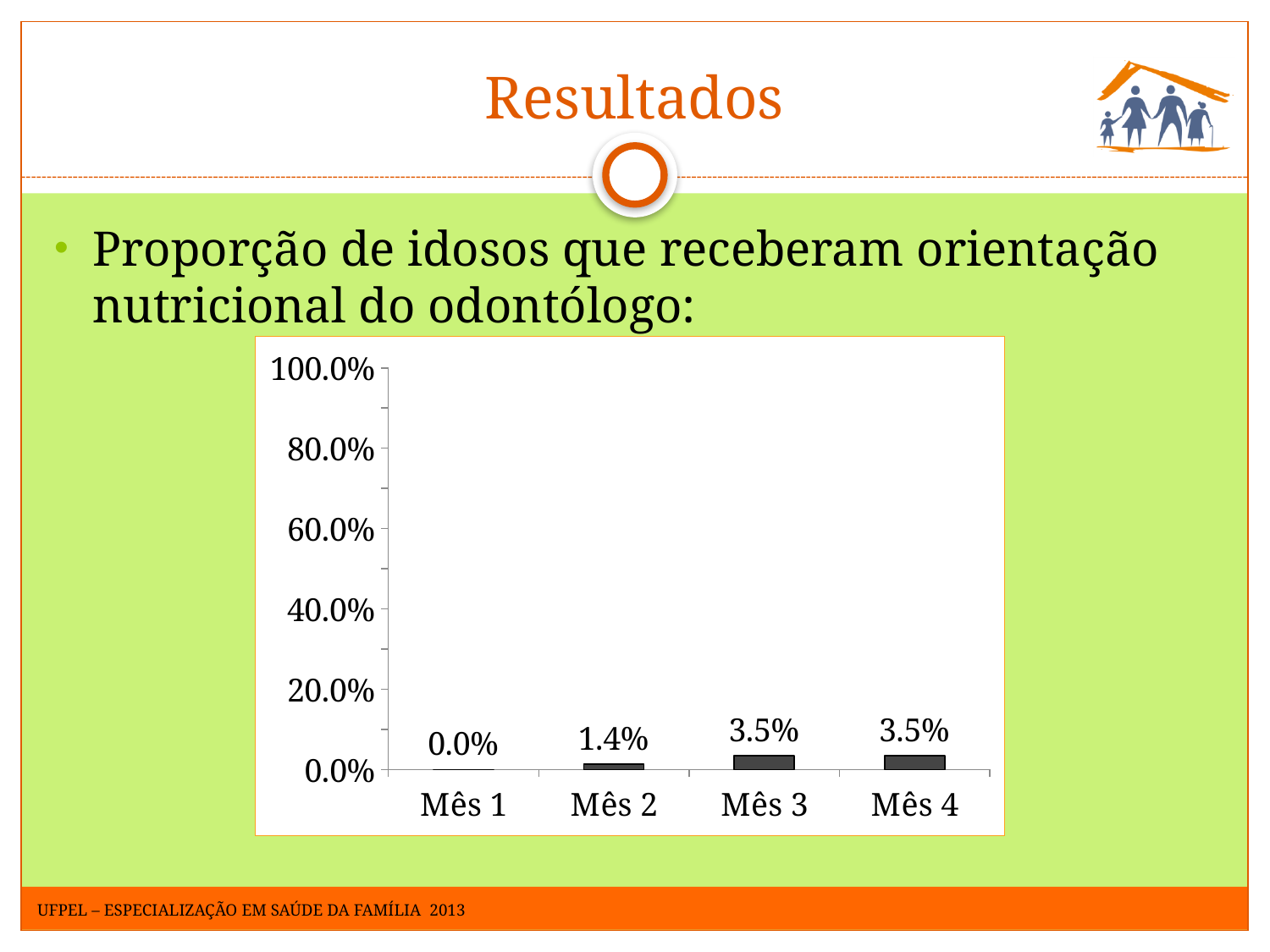
What is the difference between the values for Mês 2 and Mês 1? 1.4% What is the value for Mês 3? 3.5% What is the value for Mês 4? 3.5% Which category has the lowest value? Mês 1 Is the value for Mês 4 greater or less than 20.0%? less What is the difference between the values for Mês 3 and Mês 2? 2.1% What is the value for Mês 1? 0.0% What kind of chart is shown on the slide? bar chart How many categories are shown on the x axis? 4 Do the values rise or fall from Mês 1 to Mês 3? rise Which is larger, the value for Mês 2 or the value for Mês 3? Mês 3 What is the value for Mês 2? 1.4%